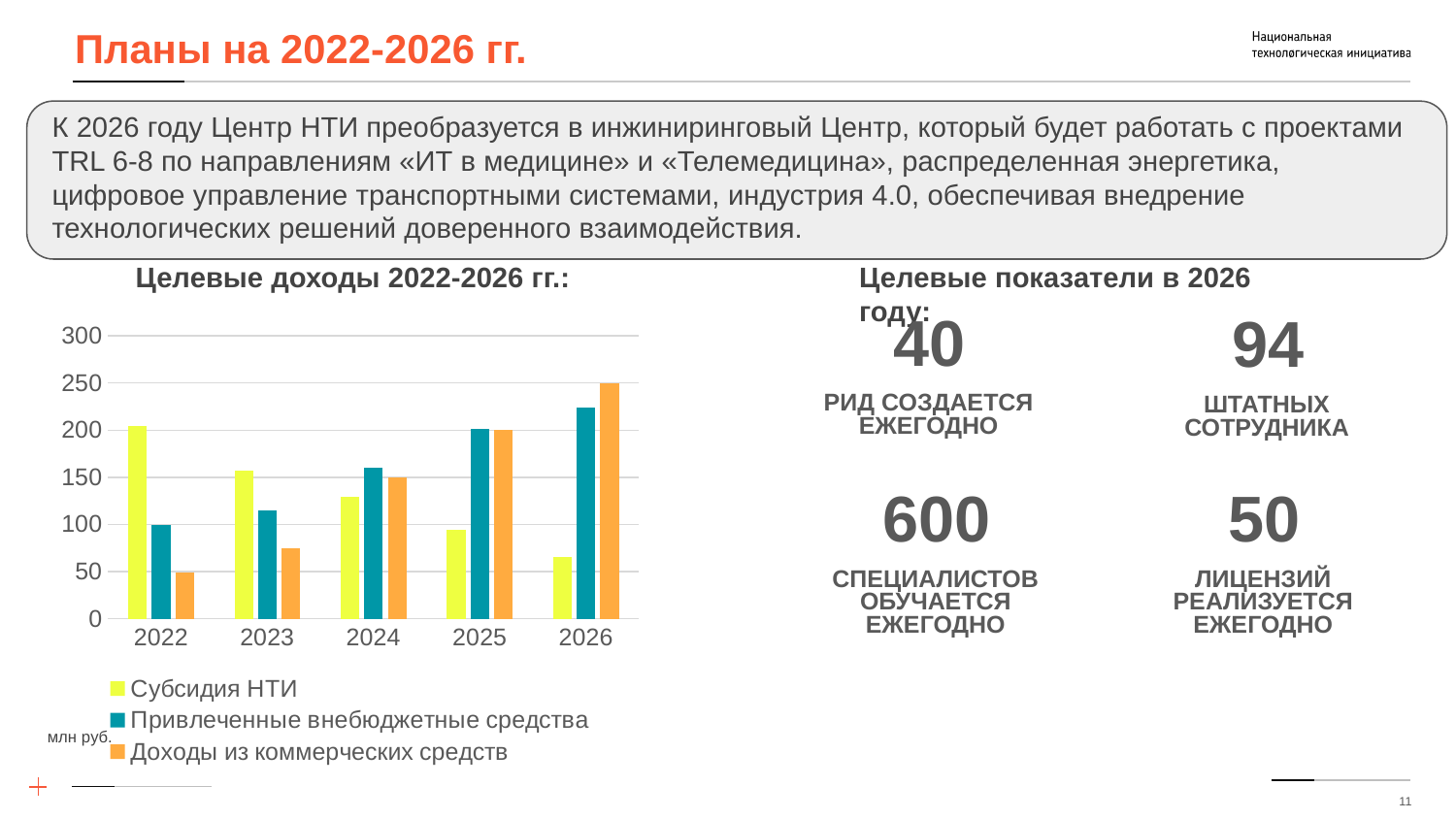
In the «Целевые доходы 2022-2026 гг.:» chart, in which year is «Субсидия НТИ» highest? 2022 What unit is indicated for the values in the «Целевые доходы 2022-2026 гг.:» chart? млн руб. What kind of chart is shown under the title «Целевые доходы 2022-2026 гг.:»? bar chart In the «Целевые доходы 2022-2026 гг.:» chart, is the value for «Доходы из коммерческих средств» in 2022 greater or less than 100? less How many years are shown on the x axis of the «Целевые доходы 2022-2026 гг.:» chart? 5 In the «Целевые доходы 2022-2026 гг.:» chart, does the value for «Доходы из коммерческих средств» rise or fall from 2022 to 2026? rise In the «Целевые доходы 2022-2026 гг.:» chart, does the value for «Субсидия НТИ» rise or fall from 2022 to 2026? fall In the «Целевые доходы 2022-2026 гг.:» chart, is the value for «Привлеченные внебюджетные средства» in 2026 greater or less than 200? greater In the «Целевые доходы 2022-2026 гг.:» chart, in which year is «Доходы из коммерческих средств» highest? 2026 In the «Целевые доходы 2022-2026 гг.:» chart, in which year is «Субсидия НТИ» lowest? 2026 In the «Целевые доходы 2022-2026 гг.:» chart, which is larger in 2022: «Субсидия НТИ» or «Привлеченные внебюджетные средства»? Субсидия НТИ How many series does the legend of the «Целевые доходы 2022-2026 гг.:» chart list? 3